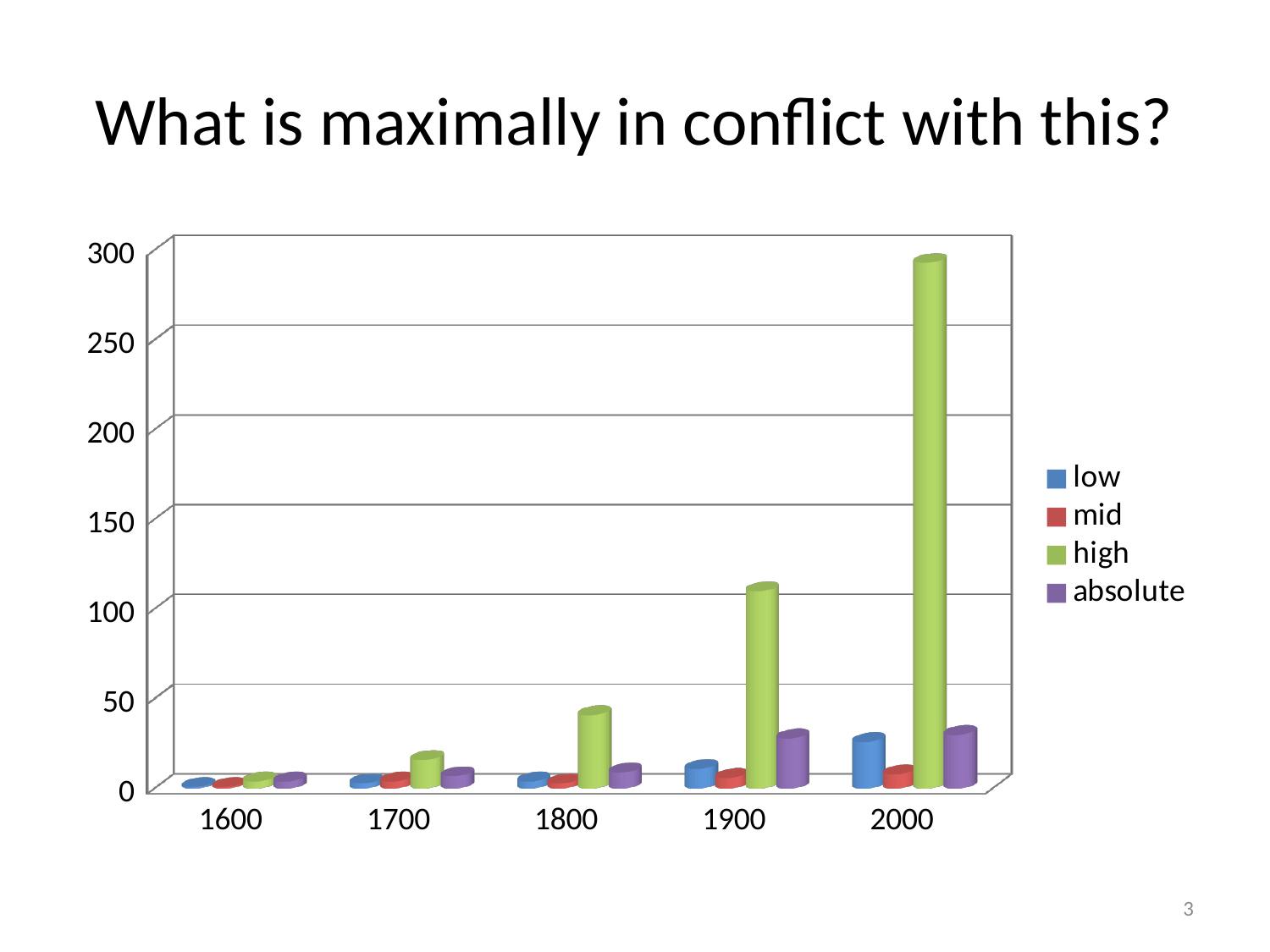
Do the values of the 'high' series rise or fall from 1600 to 2000? rise How many categories are shown along the x axis? 5 Which series is shown in green? high How many series does the legend list? 4 In 2000, which is larger, the value for 'high' or the value for 'low'? high Is the value for 'high' in 1800 greater or less than 50? less Is the value for 'high' in 2000 greater or less than 250? greater Is the value for 'high' in 1900 greater or less than 50? greater Which series are listed in the legend? low, mid, high, absolute For the 'high' series, which category has the lowest value? 1600 What kind of chart is shown on the slide? bar chart For the 'high' series, which category has the highest value? 2000